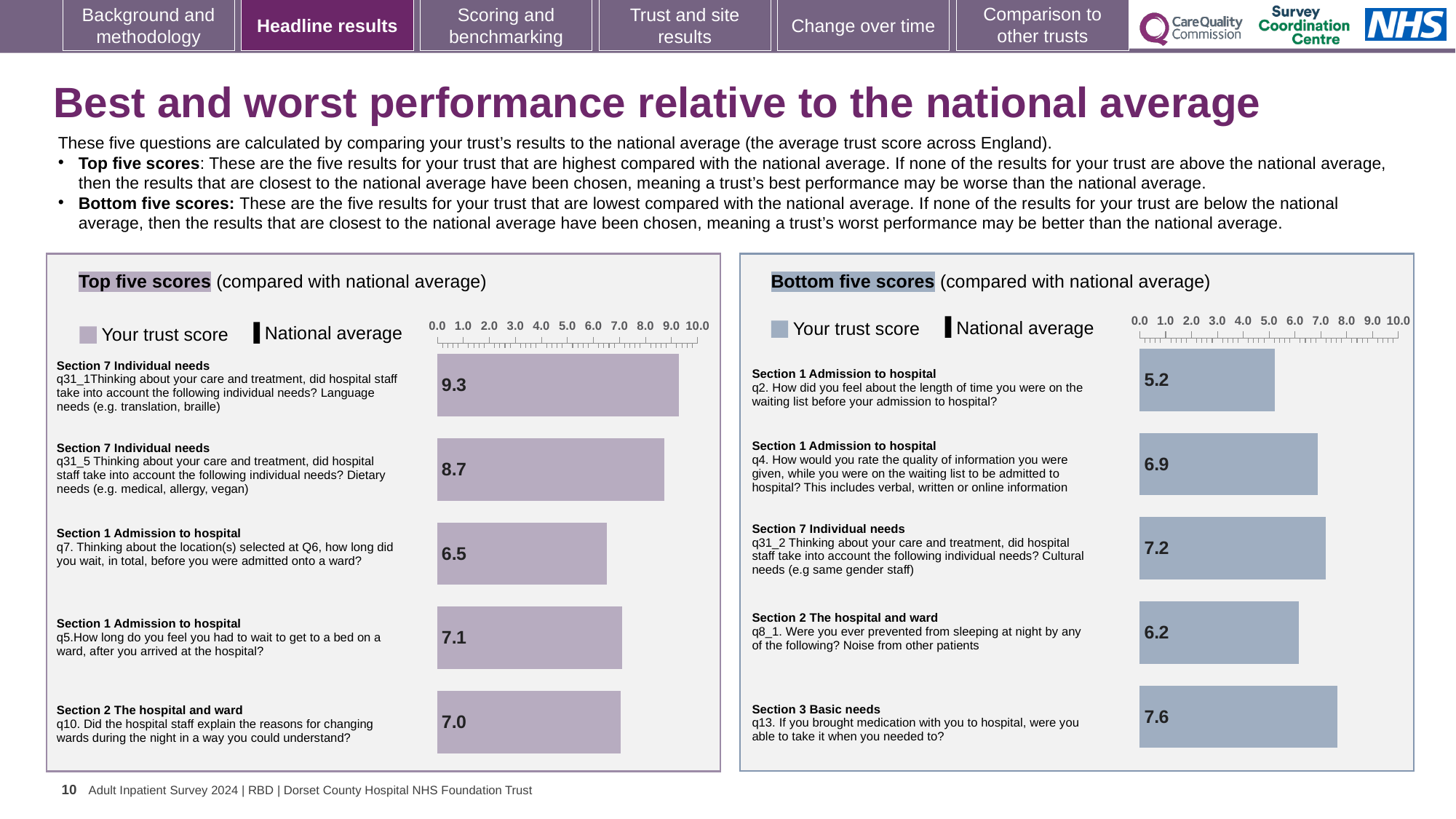
In the Bottom five scores chart, which is larger: the score for q4 (quality of information on the waiting list) or q8_1 (noise from other patients)? q4 (6.9) In the Top five scores chart, what is the trust score for q31_1 about language needs (e.g. translation, braille)? 9.3 How many bars are shown in the Bottom five scores chart? 5 What type of chart is the Top five scores chart? Bar chart In the Top five scores chart, which question has the highest trust score? q31_1 Language needs (9.3) In the Top five scores chart, which question has the lowest trust score? q7 wait before admitted onto a ward (6.5) In the Top five scores chart, what is the trust score for q7 about how long you waited before being admitted onto a ward? 6.5 In the Bottom five scores chart, what is the trust score for q2 about the length of time on the waiting list? 5.2 In the Top five scores chart, what is the difference between the scores for q31_1 (language needs) and q31_5 (dietary needs)? 0.6 In the Bottom five scores chart, what is the trust score for q13 about taking medication you brought with you? 7.6 In the Bottom five scores chart, what is the difference between the highest score (q13) and the lowest score (q2)? 2.4 In the Bottom five scores chart, which question has the lowest trust score? q2 length of time on the waiting list (5.2)